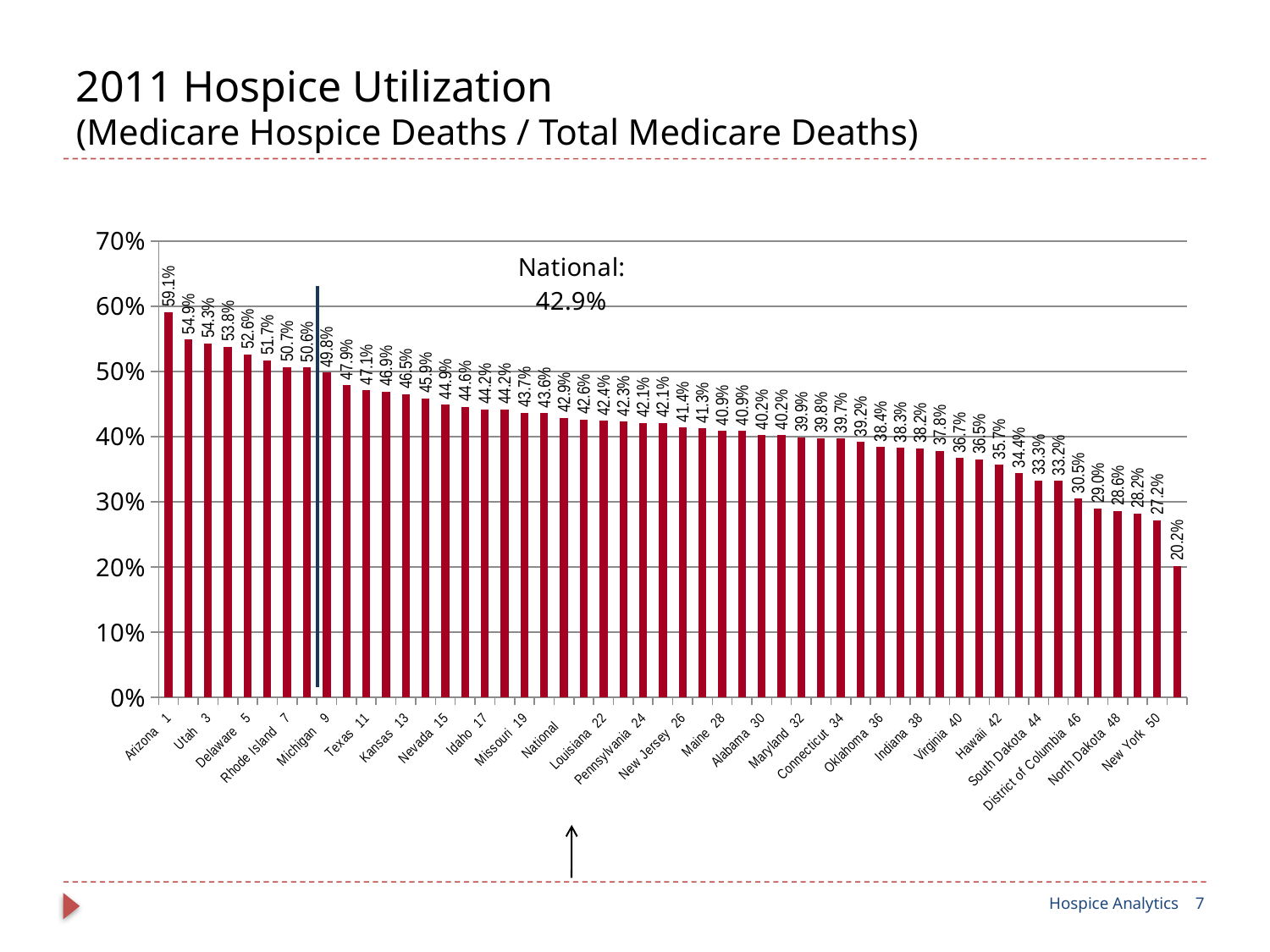
Is the value for Hawaii greater or less than 40%? less Is the value for Texas greater or less than 40%? greater Is the value for Delaware greater or less than 50%? greater What is the National hospice utilization value shown on the chart? 42.9% Which state has the highest hospice utilization on the chart? Arizona Which is larger, the value for Arizona or the National value? Arizona What kind of chart is shown on the slide? Bar chart What is the difference between Arizona's value and the National value? 16.2 percentage points What is the hospice utilization value shown for Arizona? 59.1% What is the title of the slide's chart? 2011 Hospice Utilization (Medicare Hospice Deaths / Total Medicare Deaths) Do the values rise or fall moving from left to right along the x axis? Fall